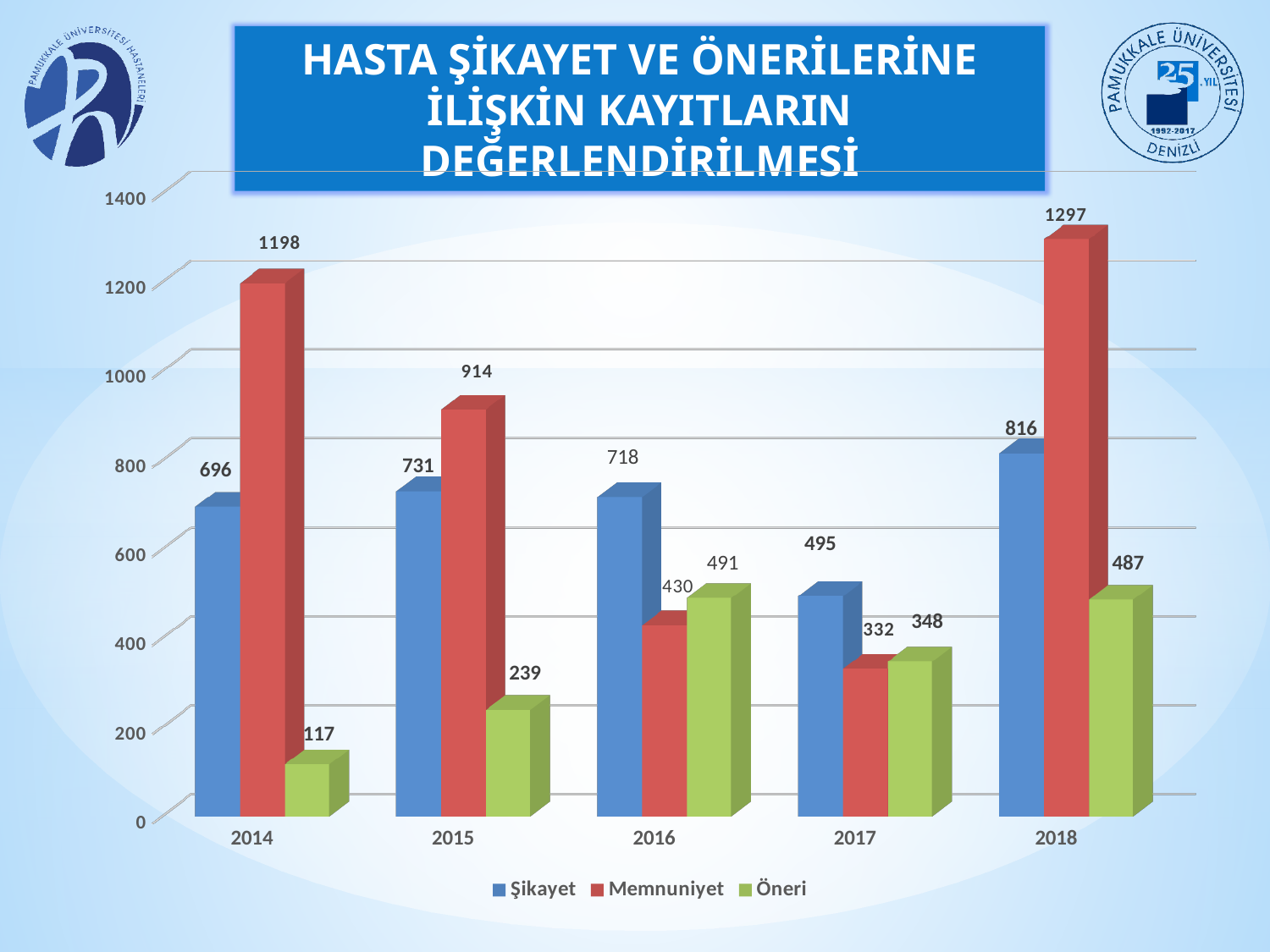
How many years are shown on the x axis? 5 Which year has the lowest Öneri value? 2014 What is the Memmuniyet value for 2018? 1297 What is the difference between the Memmuniyet values for 2014 and 2015? 284 What kind of chart is shown on the slide? bar chart Which year has the highest Memmuniyet value? 2018 Which is larger in 2016, Memmuniyet or Öneri? Öneri What is the Öneri value for 2014? 117 How many series does the legend list? 3 Is the Şikayet value for 2017 greater or less than 600? less What is the Şikayet value for 2016? 718 Which series is shown in red in the legend? Memnuniyet